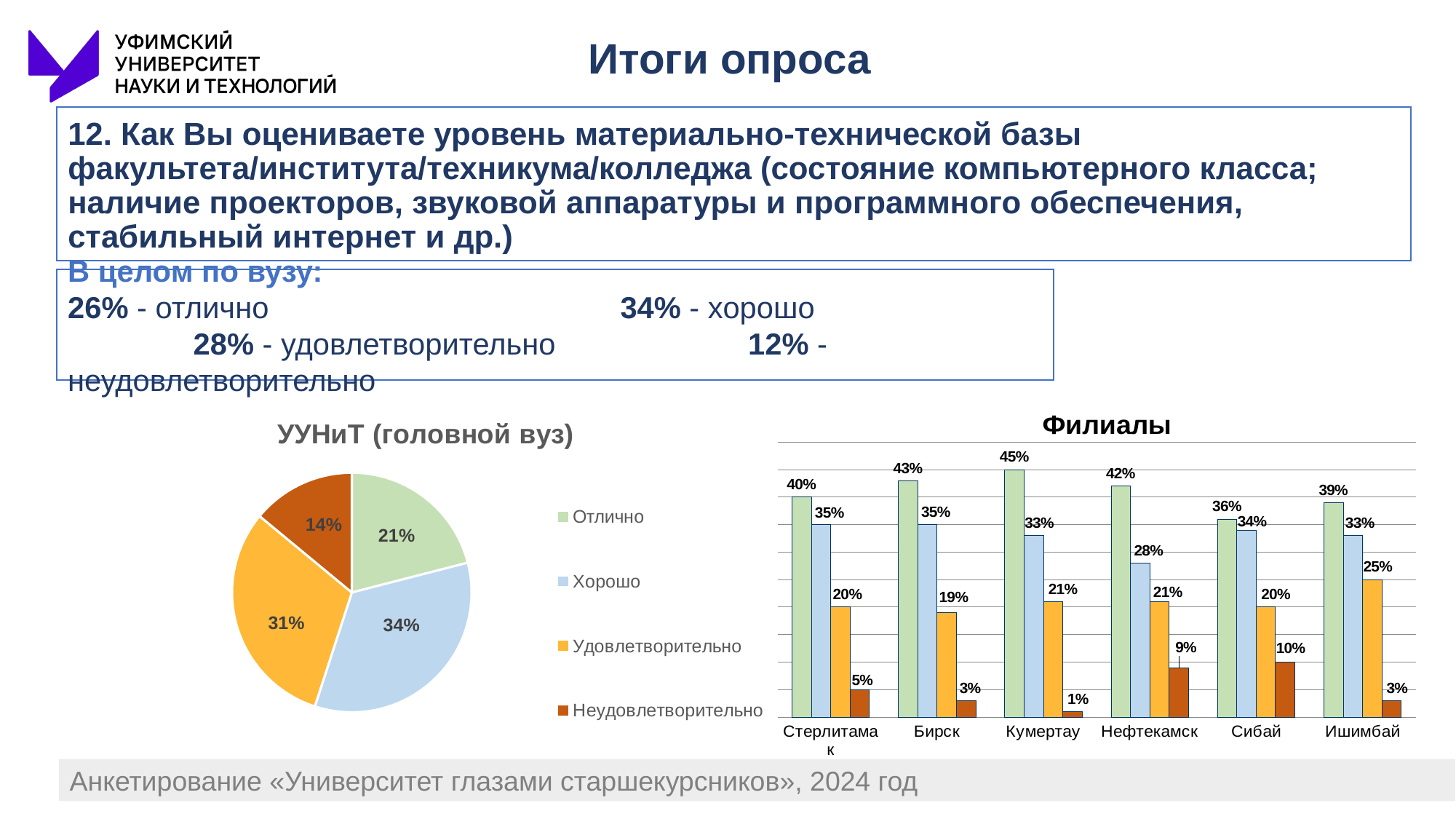
In the 'Филиалы' chart, what is the value of the Отлично (green) bar for Кумертау? 45% What type of chart is 'УУНиТ (головной вуз)'? Pie chart In the 'Филиалы' chart, which branch has the lowest Неудовлетворительно (dark orange) bar? Кумертау How many branches are shown on the x axis of the 'Филиалы' chart? 6 In the 'Филиалы' chart, what is the value of the Неудовлетворительно (dark orange) bar for Сибай? 10% In the 'УУНиТ (головной вуз)' pie chart, which category has the largest slice? Хорошо In the 'УУНиТ (головной вуз)' pie chart, which category has the smallest slice? Неудовлетворительно In the 'Филиалы' chart, what is the difference between the Удовлетворительно (yellow) bars for Ишимбай and Бирск? 6% In the 'Филиалы' chart, which is larger: the Хорошо (light blue) bar for Нефтекамск or for Сибай? Сибай In the 'Филиалы' chart, which branch has the highest Отлично (green) bar? Кумертау In the 'УУНиТ (головной вуз)' pie chart, what share is labelled for Хорошо? 34% In the 'УУНиТ (головной вуз)' pie chart, how many categories does the legend list? 4